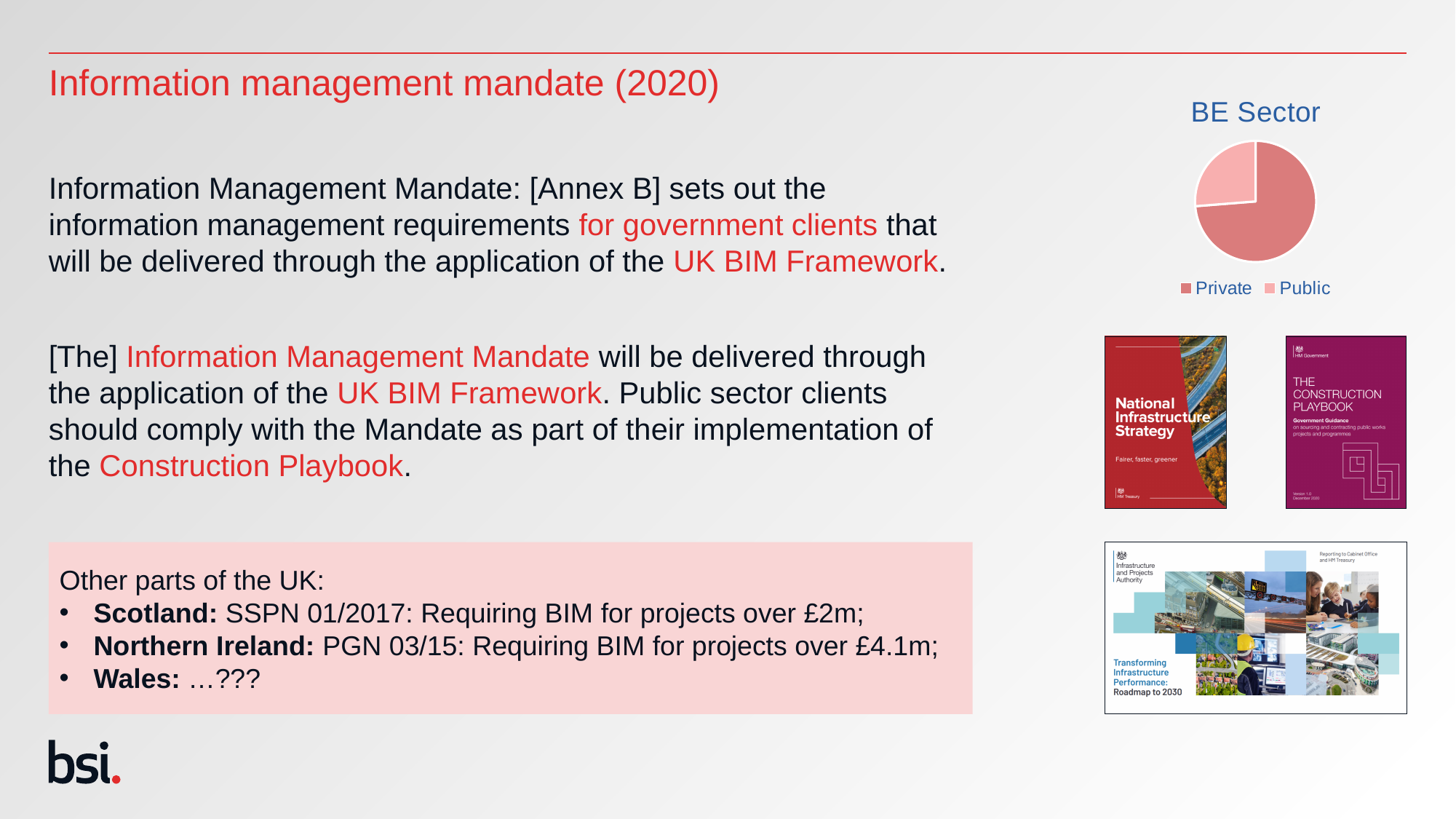
What are the two categories listed in the legend of the BE Sector pie chart? Private and Public Which category has the smallest slice in the BE Sector pie chart? Public What kind of chart is shown under the title "BE Sector"? Pie chart What is the title of the pie chart on the slide? BE Sector How many slices does the BE Sector pie chart have? 2 How many entries does the legend of the BE Sector pie chart list? 2 In the BE Sector pie chart, which slice is larger, Private or Public? Private Which category has the largest slice in the BE Sector pie chart? Private